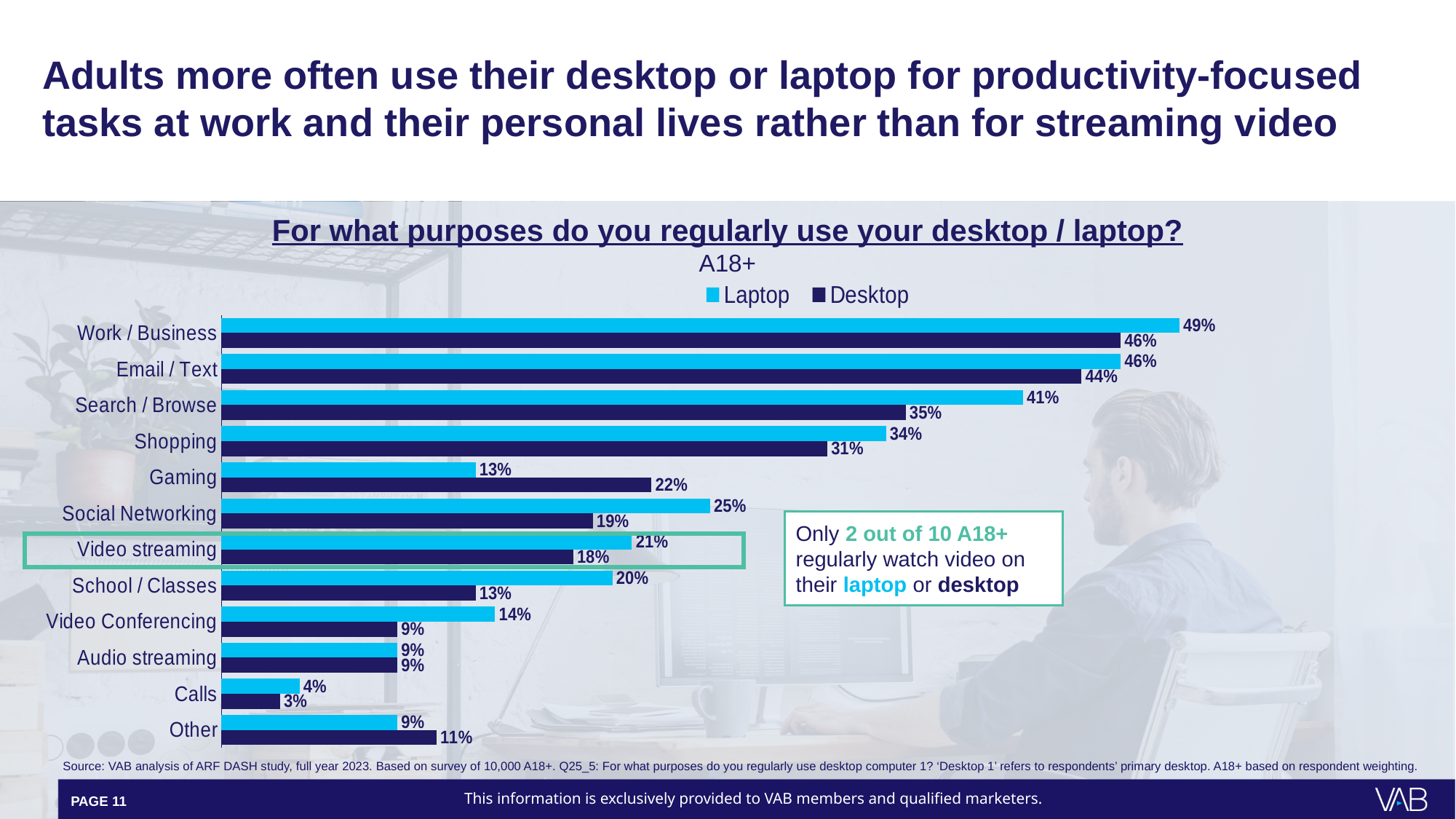
For Gaming, which is larger: the Laptop value or the Desktop value? Desktop What is the difference between the Laptop and Desktop values for Search / Browse? 6% Which category has the lowest Desktop value? Calls What percentage of A18+ regularly use their laptop for Work / Business? 49% How many categories are shown on the chart? 12 For Other, which is larger: the Laptop value or the Desktop value? Desktop What is the Desktop value for Video streaming? 18% What is the Laptop value for Gaming? 13% Which series is shown in light blue in the legend? Laptop How many series does the legend list? 2 What kind of chart is shown on the slide? Bar chart Which category has the highest Laptop value? Work / Business